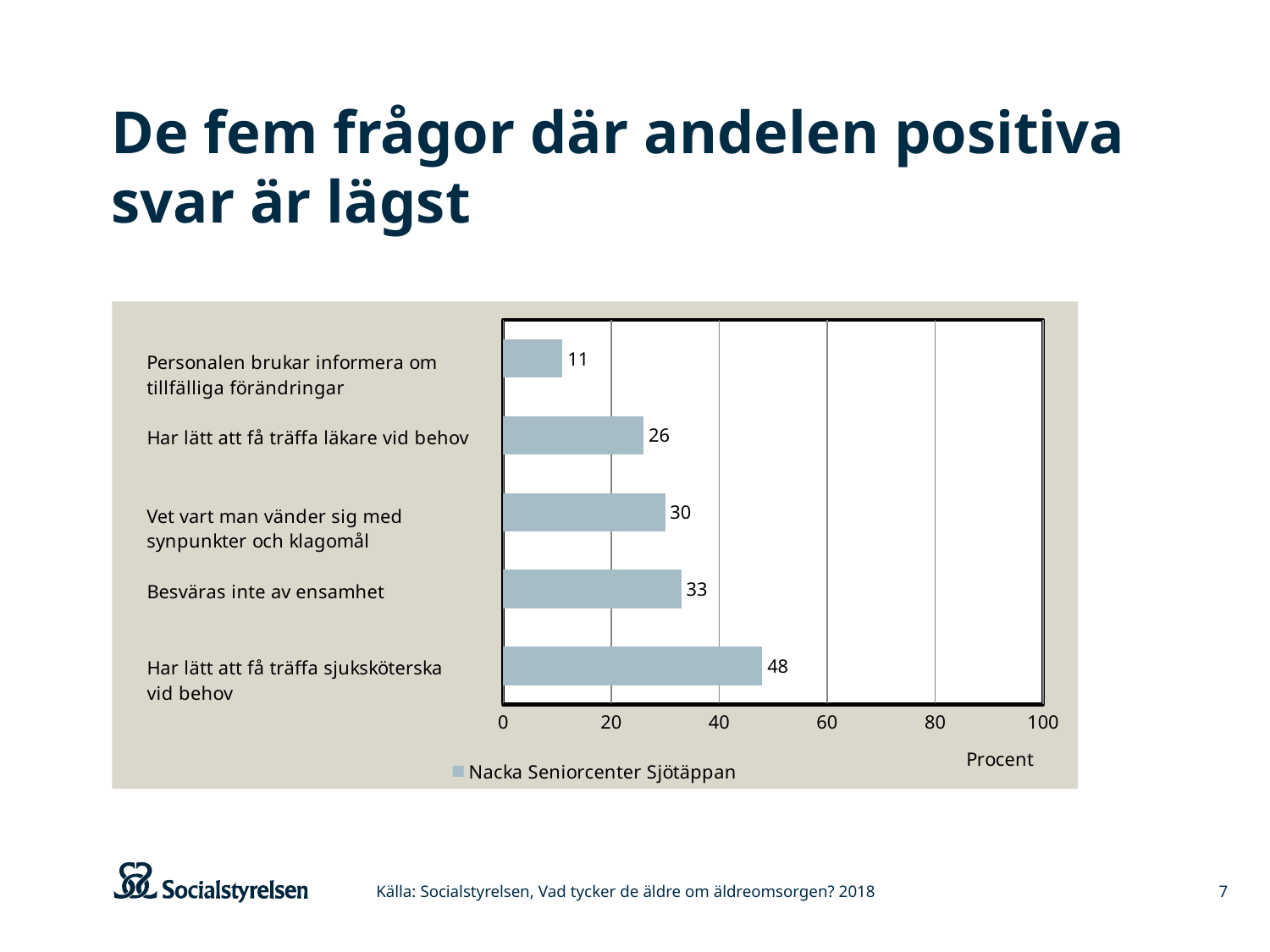
Which category has the highest value? Har lätt att få träffa sjuksköterska vid behov Which is larger, the value for "Besväras inte av ensamhet" or the value for "Har lätt att få träffa läkare vid behov"? Besväras inte av ensamhet How many categories are shown in the chart? 5 What is the value for "Personalen brukar informera om tillfälliga förändringar"? 11 What is the value for "Har lätt att få träffa sjuksköterska vid behov"? 48 Is the value for "Har lätt att få träffa sjuksköterska vid behov" greater or less than 40? greater What is the value for "Besväras inte av ensamhet"? 33 What kind of chart is shown on the slide? bar chart What is the value for "Vet vart man vänder sig med synpunkter och klagomål"? 30 What series name does the legend show? Nacka Seniorcenter Sjötäppan Which category has the lowest value? Personalen brukar informera om tillfälliga förändringar What is the difference between the values for "Har lätt att få träffa sjuksköterska vid behov" and "Har lätt att få träffa läkare vid behov"? 22